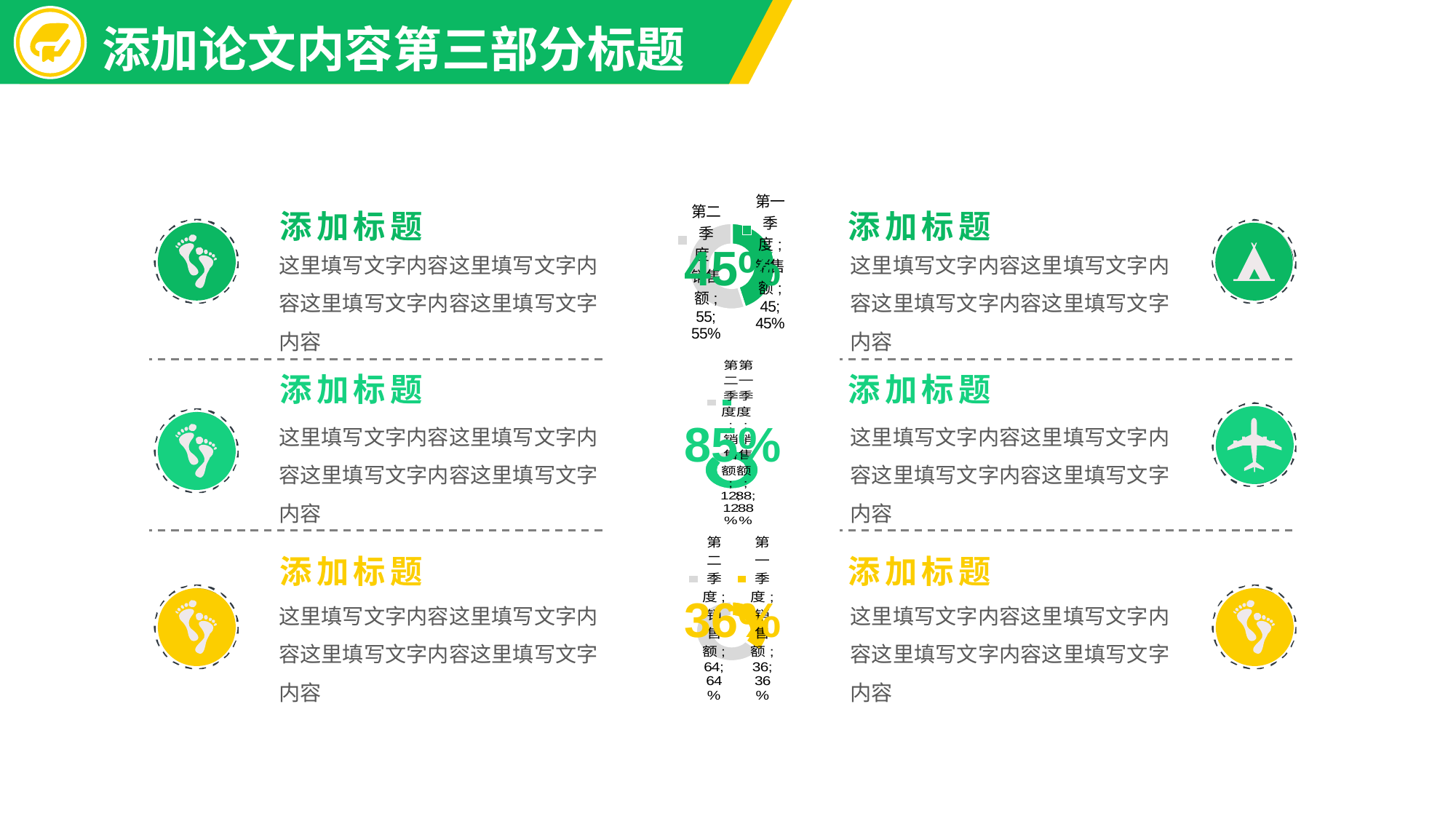
In the bottom chart in the centre of the slide, what is the difference between the values for 第二季度 and 第一季度? 28 In the top chart in the centre of the slide, what is the value for 第一季度? 45 In the bottom chart in the centre of the slide, what is the value for 第一季度? 36 In the top chart in the centre of the slide, what share of the whole does 第二季度 represent? 55% In the bottom chart in the centre of the slide, what share of the whole does 第一季度 represent? 36% How many categories does the top chart in the centre of the slide show? 2 In the top chart in the centre of the slide, which category is larger, 第一季度 or 第二季度? 第二季度 In the bottom chart in the centre of the slide, what is the value for 第二季度? 64 In the top chart in the centre of the slide, what is the difference between the values for 第二季度 and 第一季度? 10 In the bottom chart in the centre of the slide, which category is the largest? 第二季度 What kind of chart is the top chart in the centre of the slide? Doughnut (pie) chart In the top chart in the centre of the slide, what is the value for 第二季度? 55